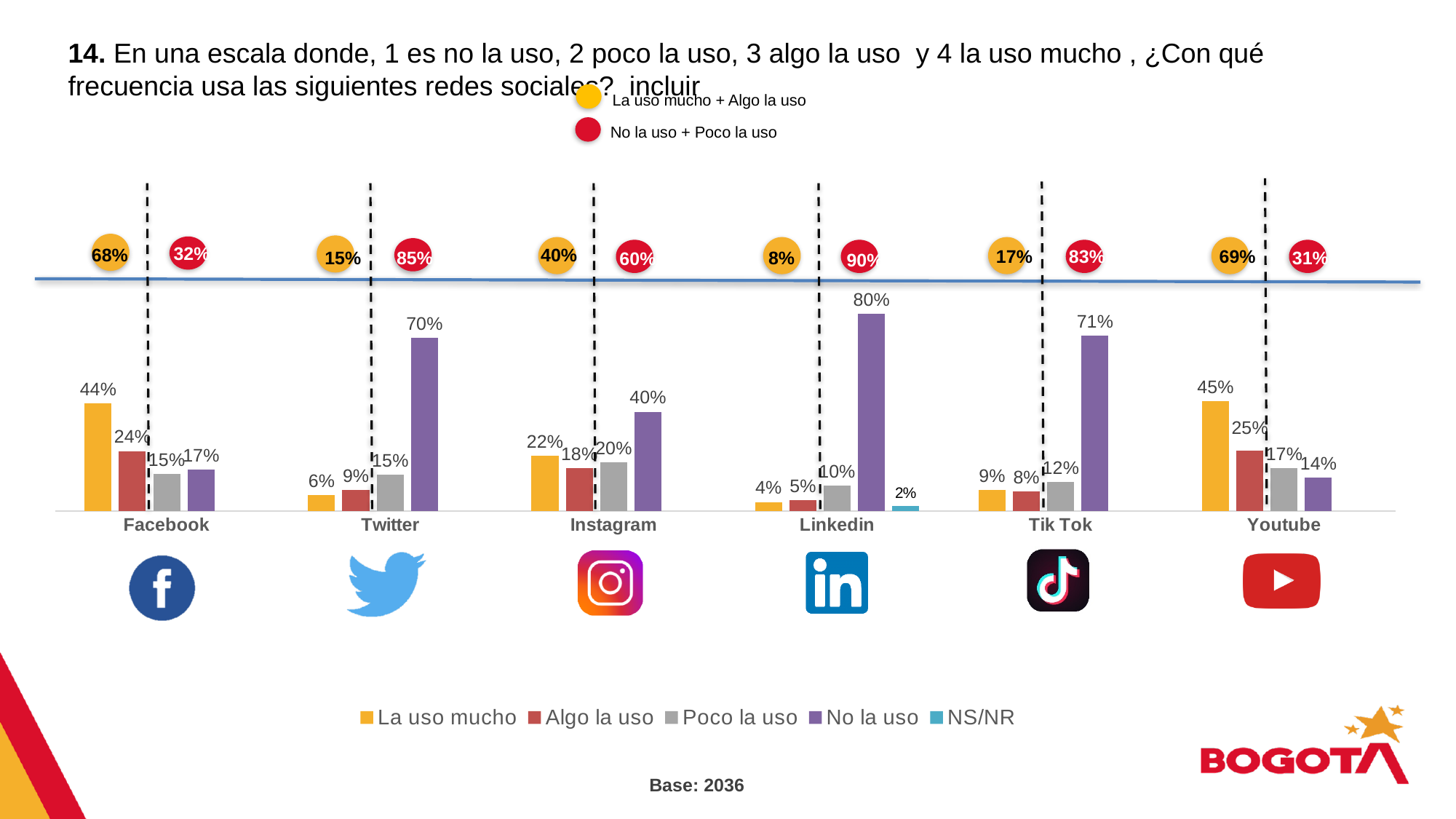
What is the value of "NS/NR" for Linkedin? 2% What is the combined "No la uso + Poco la uso" percentage shown in the red circle for Tik Tok? 83% How many series does the chart legend list? 5 What is the value of "La uso mucho" for Facebook? 44% How many social networks are shown on the x axis of the chart? 6 Which social network has the highest "La uso mucho" value? Youtube What is the value of "Poco la uso" for Instagram? 20% What is the difference between the "No la uso" values for Twitter and Instagram? 30% What is the value of "No la uso" for Linkedin? 80% Which is larger: "Algo la uso" for Facebook or "Algo la uso" for Youtube? Youtube What kind of chart is shown on the slide? Bar chart Which social network has the lowest "No la uso" value? Youtube